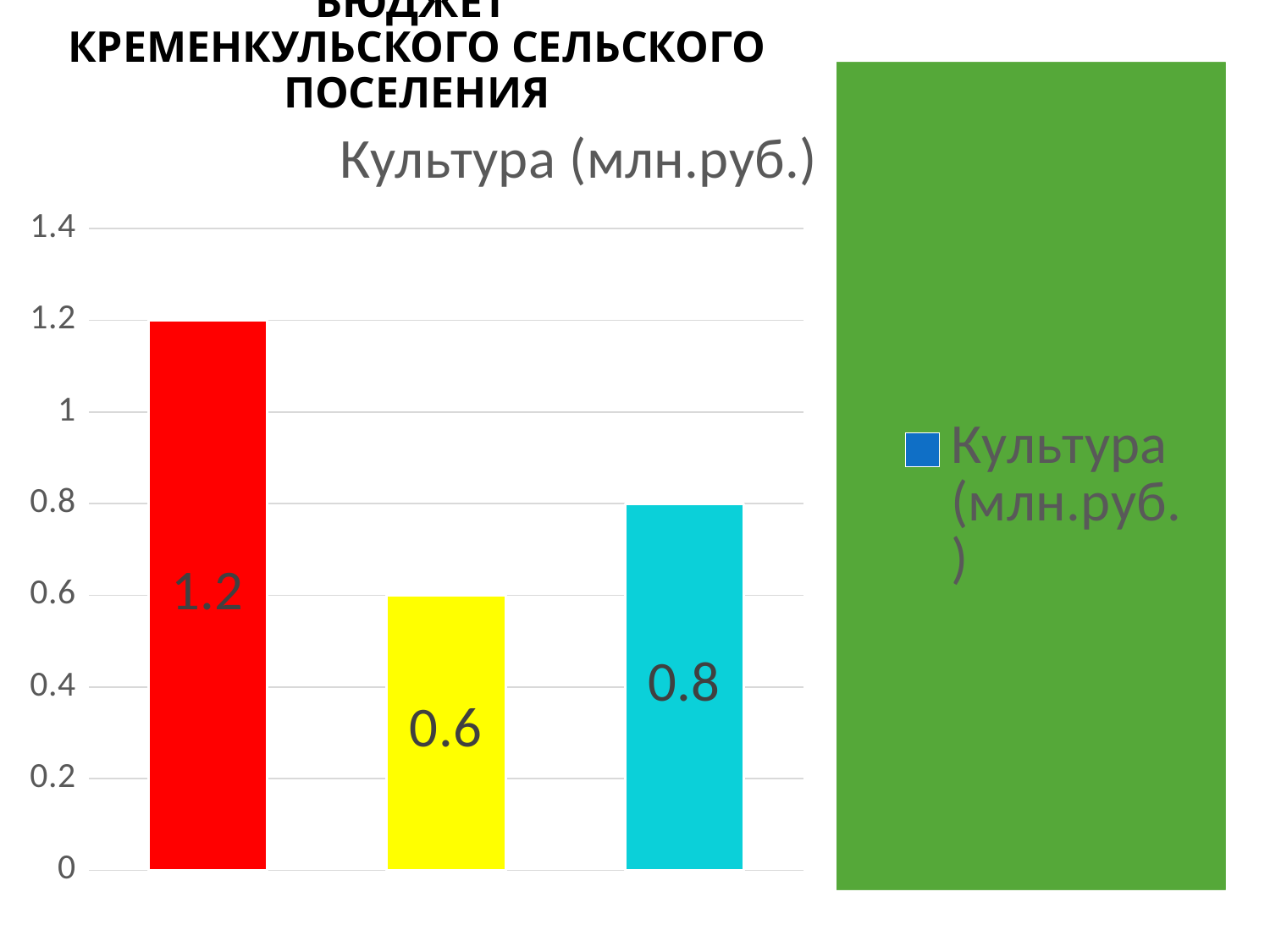
What is the value of the yellow bar? 0.6 Which is larger, the cyan bar or the yellow bar? The cyan bar What kind of chart is shown on the slide? Bar chart Which bar has the lowest value? The yellow (middle) bar, 0.6 What is the difference between the red bar and the yellow bar? 0.6 What is the value of the cyan (rightmost) bar? 0.8 What is the value of the red bar? 1.2 How many series does the legend list? 1 What is the difference between the cyan bar and the yellow bar? 0.2 How many bars are plotted in the chart? 3 Which bar has the highest value? The red (leftmost) bar, 1.2 What is the title of the chart? Культура (млн.руб.)